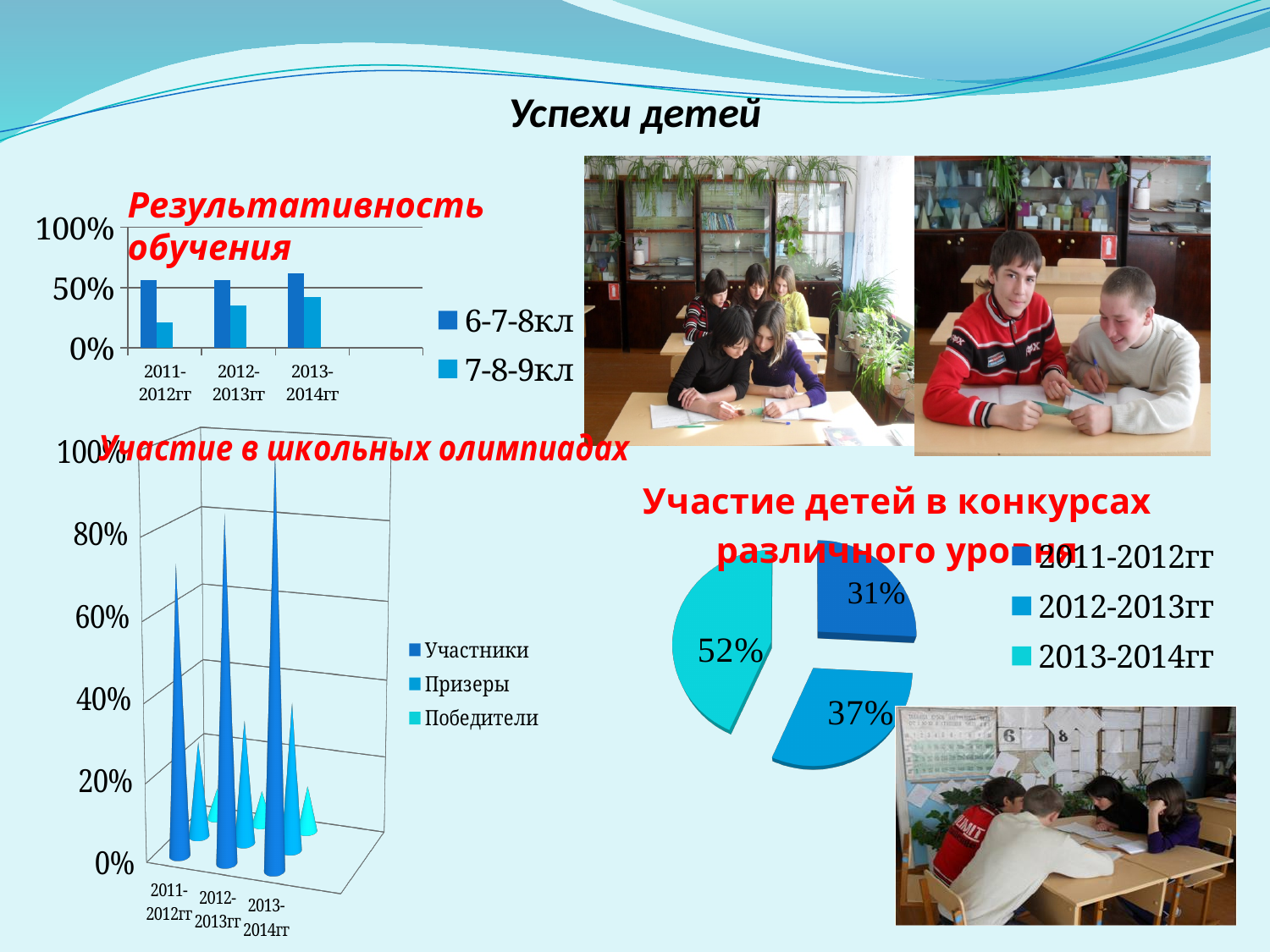
How many entries does the legend of the pie chart 'Участие детей в конкурсах различного уровня' list? 3 In the chart 'Результативность обучения', is the value for 7-8-9кл in 2011-2012гг greater or less than 50%? less In the chart 'Результативность обучения', is the value for 6-7-8кл in 2013-2014гг greater or less than 50%? greater In the pie chart 'Участие детей в конкурсах различного уровня', which year has the smallest slice? 2011-2012гг In the pie chart 'Участие детей в конкурсах различного уровня', which year has the largest slice? 2013-2014гг In the pie chart 'Участие детей в конкурсах различного уровня', what share is shown for 2013-2014гг? 52% In the pie chart 'Участие детей в конкурсах различного уровня', what is the difference between the 2012-2013гг and 2011-2012гг slices? 6% In the pie chart 'Участие детей в конкурсах различного уровня', what share is shown for 2011-2012гг? 31% In the chart 'Участие в школьных олимпиадах', how many series does the legend list? 3 What kind of chart is 'Результативность обучения' in the top left? Bar chart In the chart 'Результативность обучения', which series has the larger value in 2011-2012гг, 6-7-8кл or 7-8-9кл? 6-7-8кл In the chart 'Участие в школьных олимпиадах', do the values for Участники rise or fall from 2011-2012гг to 2013-2014гг? rise